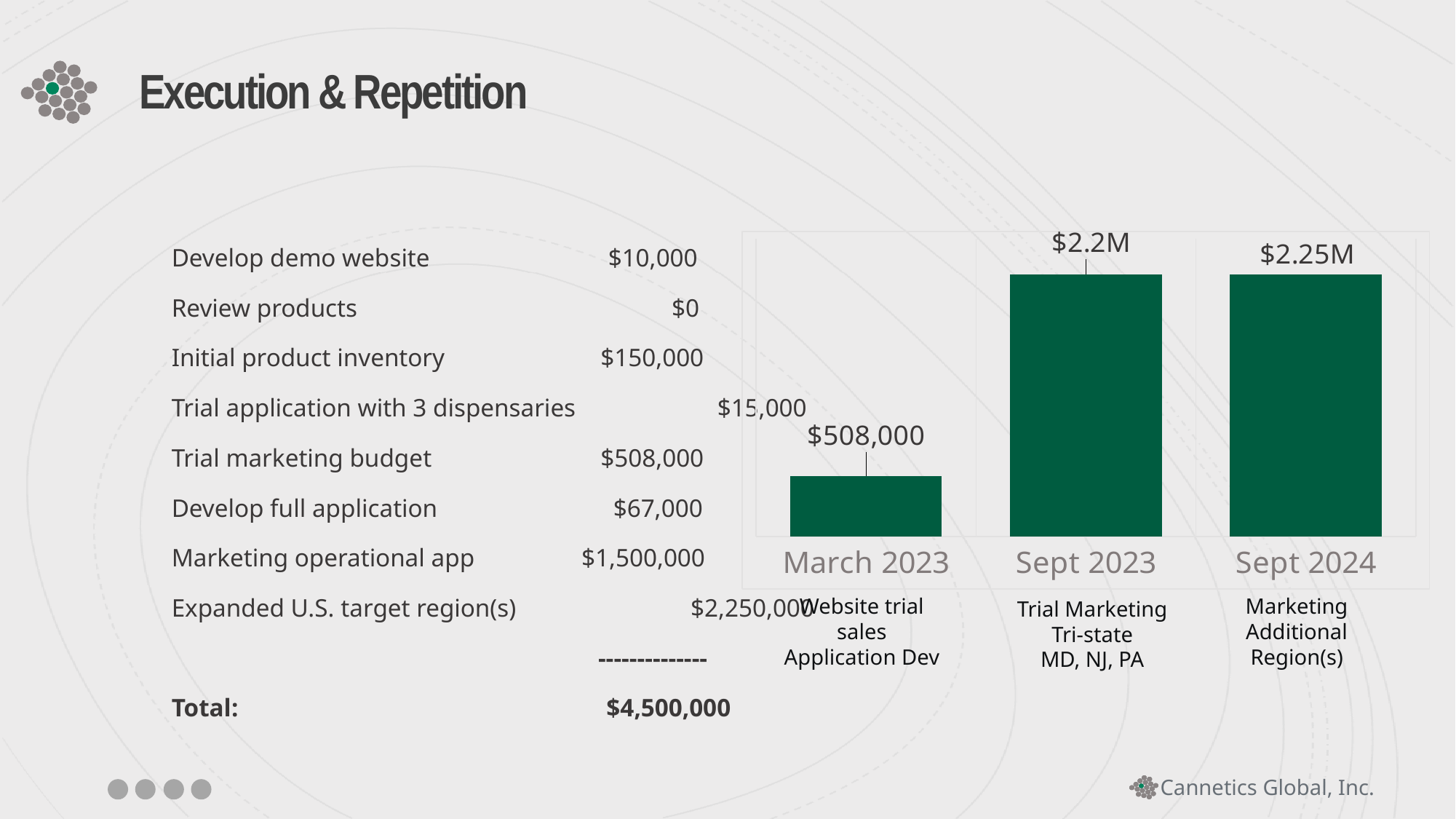
What value is shown for Sept 2023 in the bar chart? $2.2M Which period has the highest value in the bar chart? Sept 2024 Do the values in the bar chart rise or fall from March 2023 to Sept 2024? Rise Which period has the lowest value in the bar chart? March 2023 What description appears under the Sept 2023 bar in the chart? Trial Marketing Tri-state MD, NJ, PA What colour are the bars in the chart? Dark green What value is shown for Sept 2024 in the bar chart? $2.25M What value is shown for March 2023 in the bar chart? $508,000 What kind of chart is shown on the slide? Bar chart How many bars are plotted in the chart? 3 Which is larger in the bar chart, the value for March 2023 or the value for Sept 2023? Sept 2023